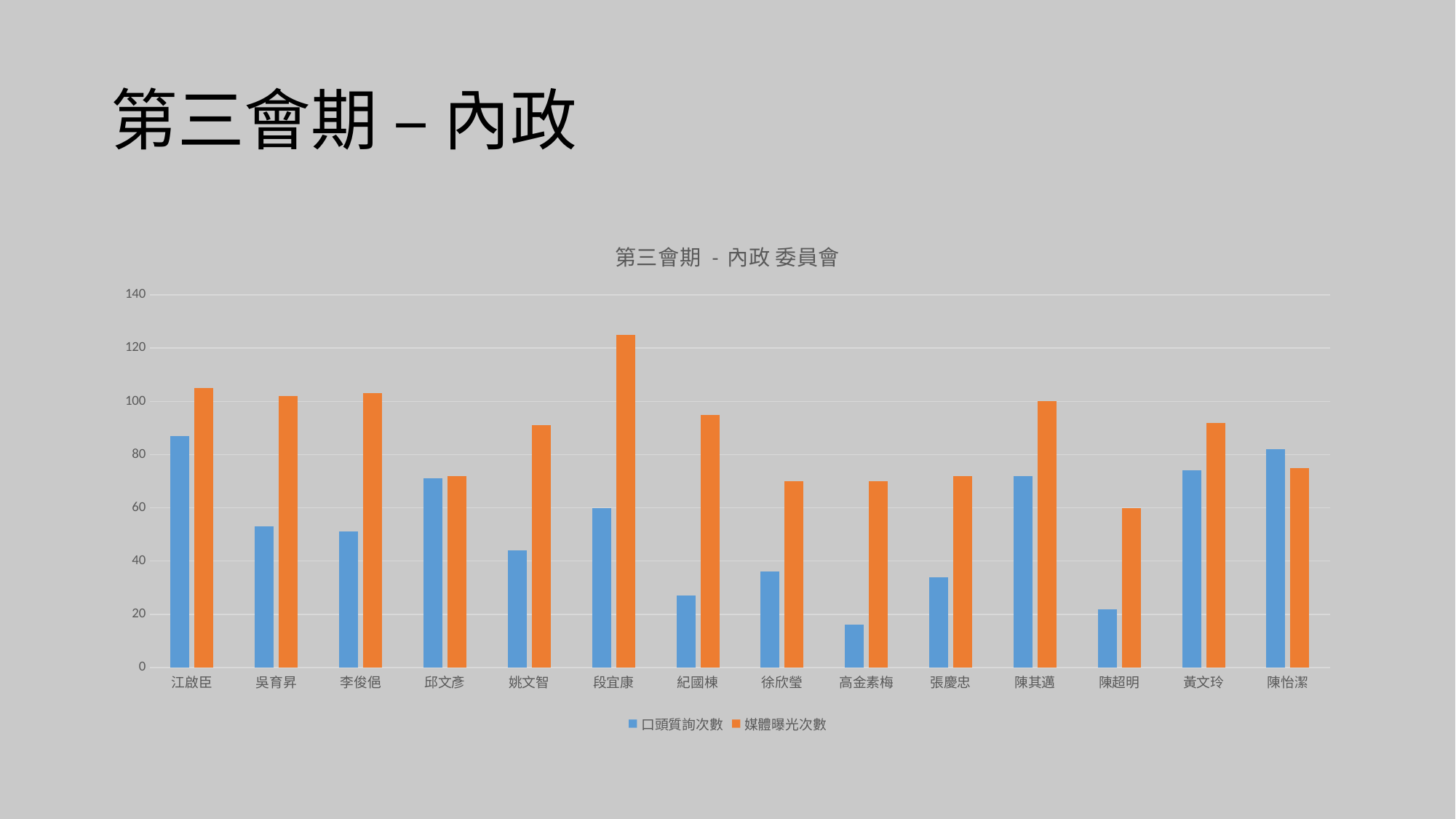
Who has the larger 口頭質詢次數, 江啟臣 or 吳育昇? 江啟臣 Is the 口頭質詢次數 value for 江啟臣 greater or less than 80? greater Is the 媒體曝光次數 value for 徐欣瑩 greater or less than 80? less Which legislator has the lowest 口頭質詢次數? 高金素梅 Is the 口頭質詢次數 value for 高金素梅 greater or less than 20? less For 陳怡潔, which is larger: 口頭質詢次數 or 媒體曝光次數? 口頭質詢次數 Which legislator has the highest 媒體曝光次數? 段宜康 How many series does the legend list? 2 What kind of chart is shown on the slide? bar chart What is the title of the chart? 第三會期 - 內政 委員會 How many legislators (categories) are shown on the x axis? 14